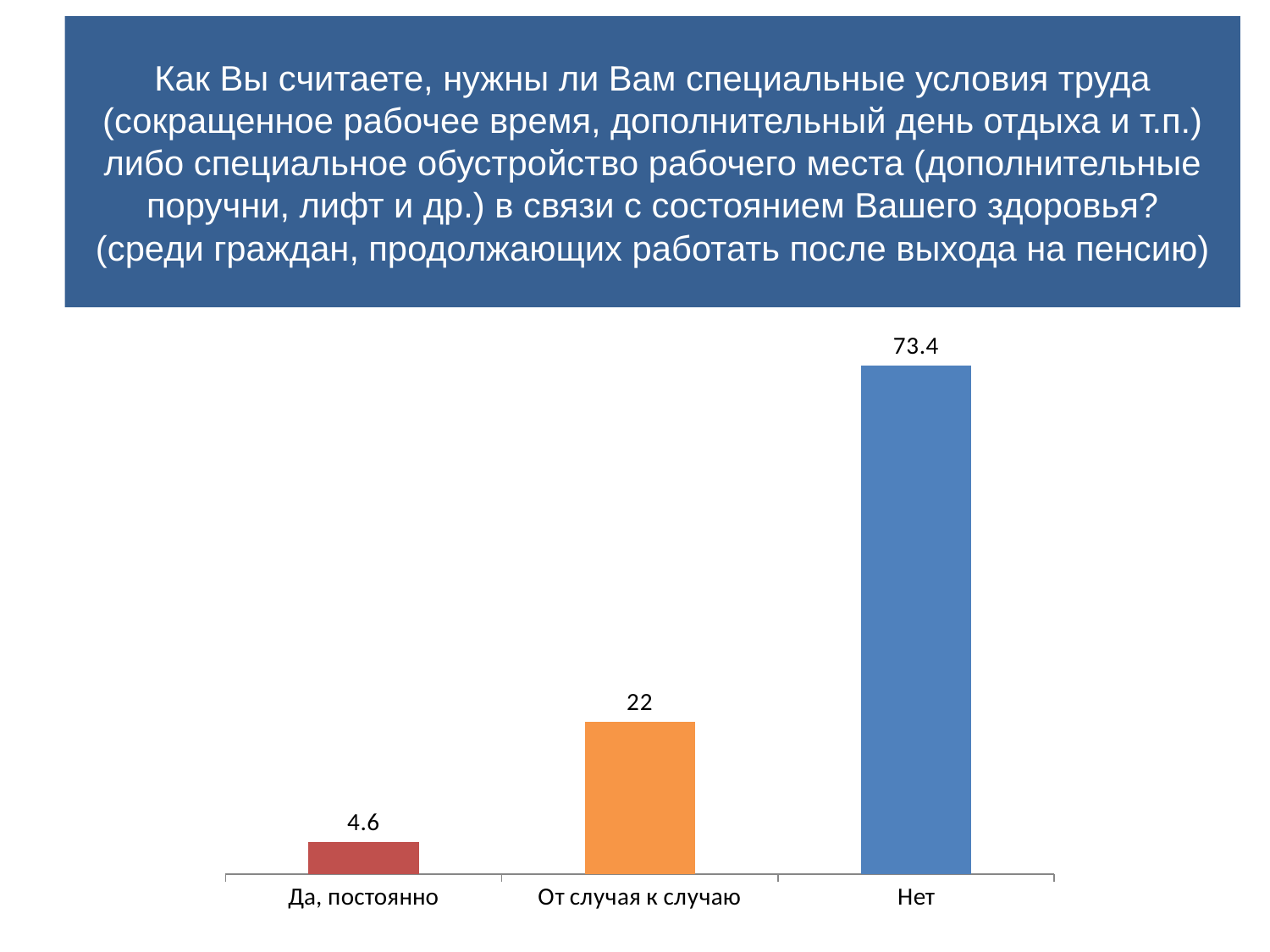
Which category has the lowest value? Да, постоянно Which is larger, the value for "От случая к случаю" or the value for "Да, постоянно"? От случая к случаю What is the value for "Да, постоянно"? 4.6 Which category has the highest value? Нет What is the value for "От случая к случаю"? 22 What colour is the bar for "От случая к случаю"? orange How many categories are shown on the x axis? 3 Do the values rise or fall from left to right along the x axis? rise What is the difference between the values for "От случая к случаю" and "Да, постоянно"? 17.4 What is the value for "Нет"? 73.4 What kind of chart is shown on the slide? bar chart What is the difference between the values for "Нет" and "От случая к случаю"? 51.4